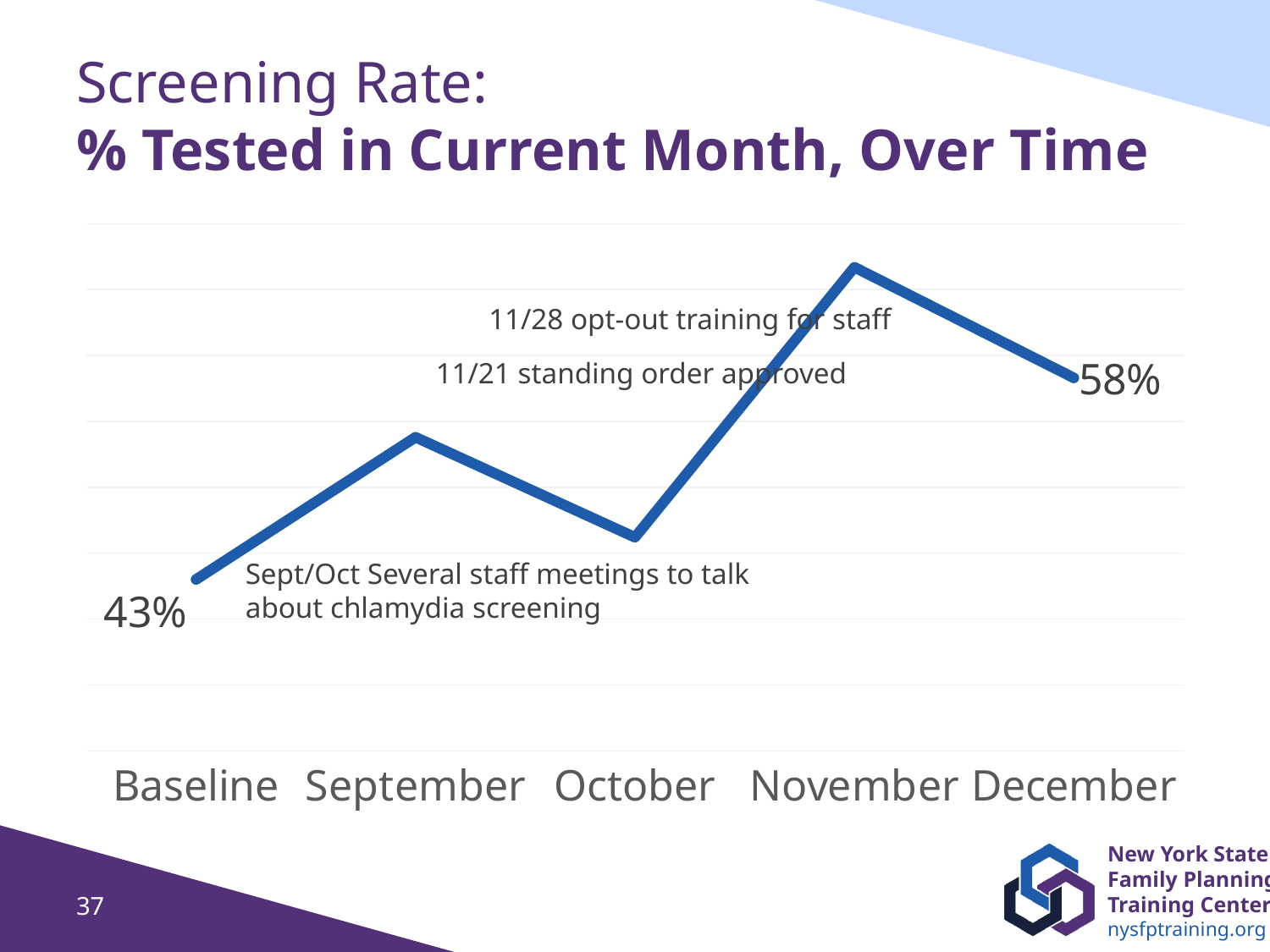
Which month has the highest screening rate? November What kind of chart is shown on the slide? Line chart By how many percentage points does the December screening rate exceed the Baseline rate? 15 percentage points Which is higher, the screening rate in November or in December? November How many time points are plotted on the chart? 5 Overall, is the screening rate in December higher or lower than at Baseline? Higher Which point on the chart has the lowest screening rate? Baseline Does the screening rate rise or fall from November to December? Fall What is the screening rate in December? 58% What is the screening rate at Baseline? 43% Which is higher, the screening rate in September or in October? September What event is annotated on the chart for 11/21? Standing order approved